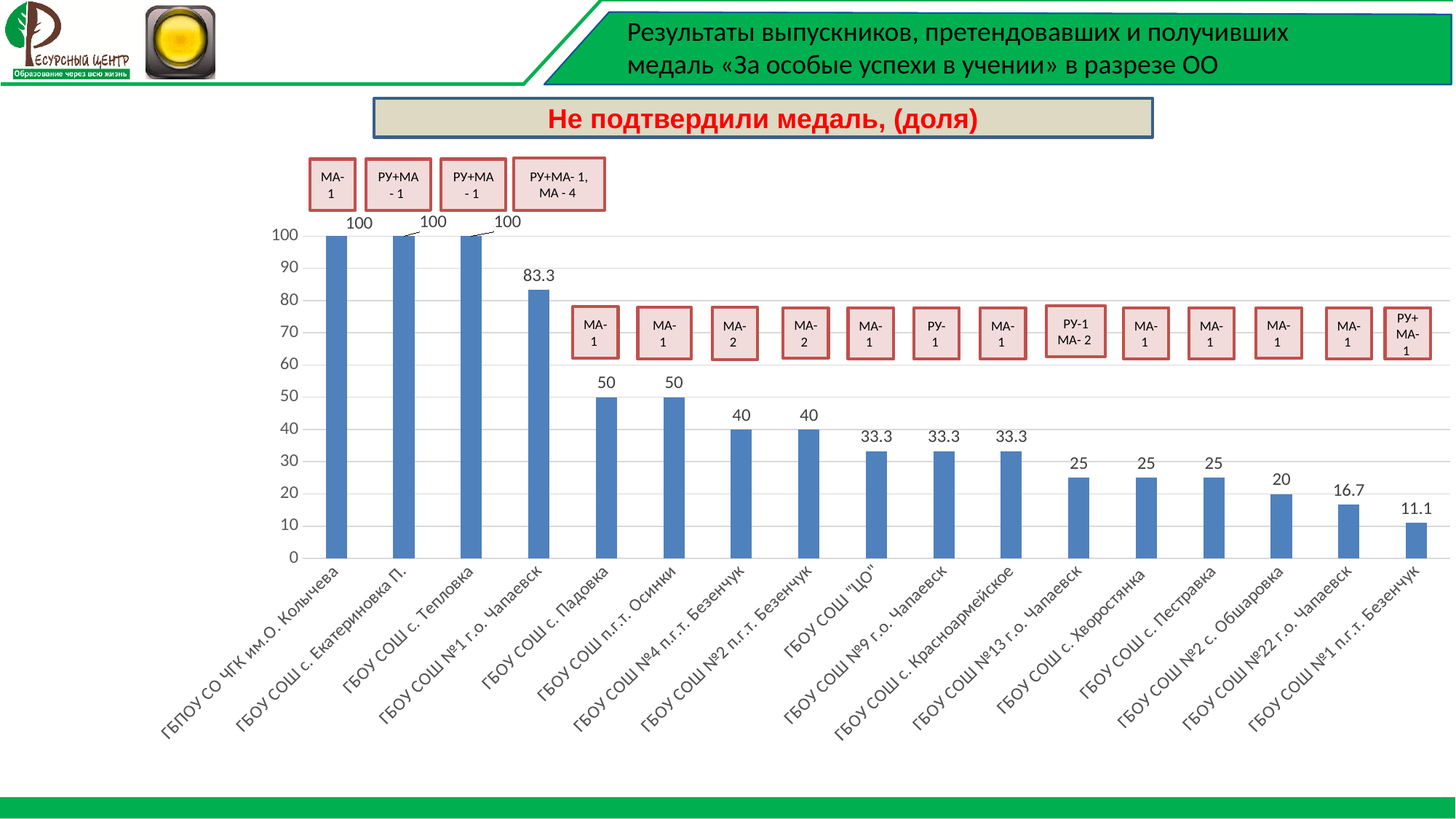
What is the difference between the values for ГБОУ СОШ №4 п.г.т. Безенчук and ГБОУ СОШ №13 г.о. Чапаевск? 15 Do the values rise or fall from left to right along the x axis? fall Which is larger, the value for ГБОУ СОШ "ЦО" or the value for ГБОУ СОШ с. Хворостянка? ГБОУ СОШ "ЦО" How many categories are shown on the x axis? 17 What is the title shown above the chart? Не подтвердили медаль, (доля) What value is shown for ГБОУ СОШ с. Падовка? 50 What value is shown for ГБОУ СОШ №2 с. Обшаровка? 20 What value is shown for ГБОУ СОШ №1 г.о. Чапаевск? 83.3 Which category has the lowest value? ГБОУ СОШ №1 п.г.т. Безенчук What is the difference between the values for ГБОУ СОШ №1 г.о. Чапаевск and ГБОУ СОШ с. Падовка? 33.3 What value is shown for ГБОУ СОШ №22 г.о. Чапаевск? 16.7 What kind of chart is shown on the slide? bar chart